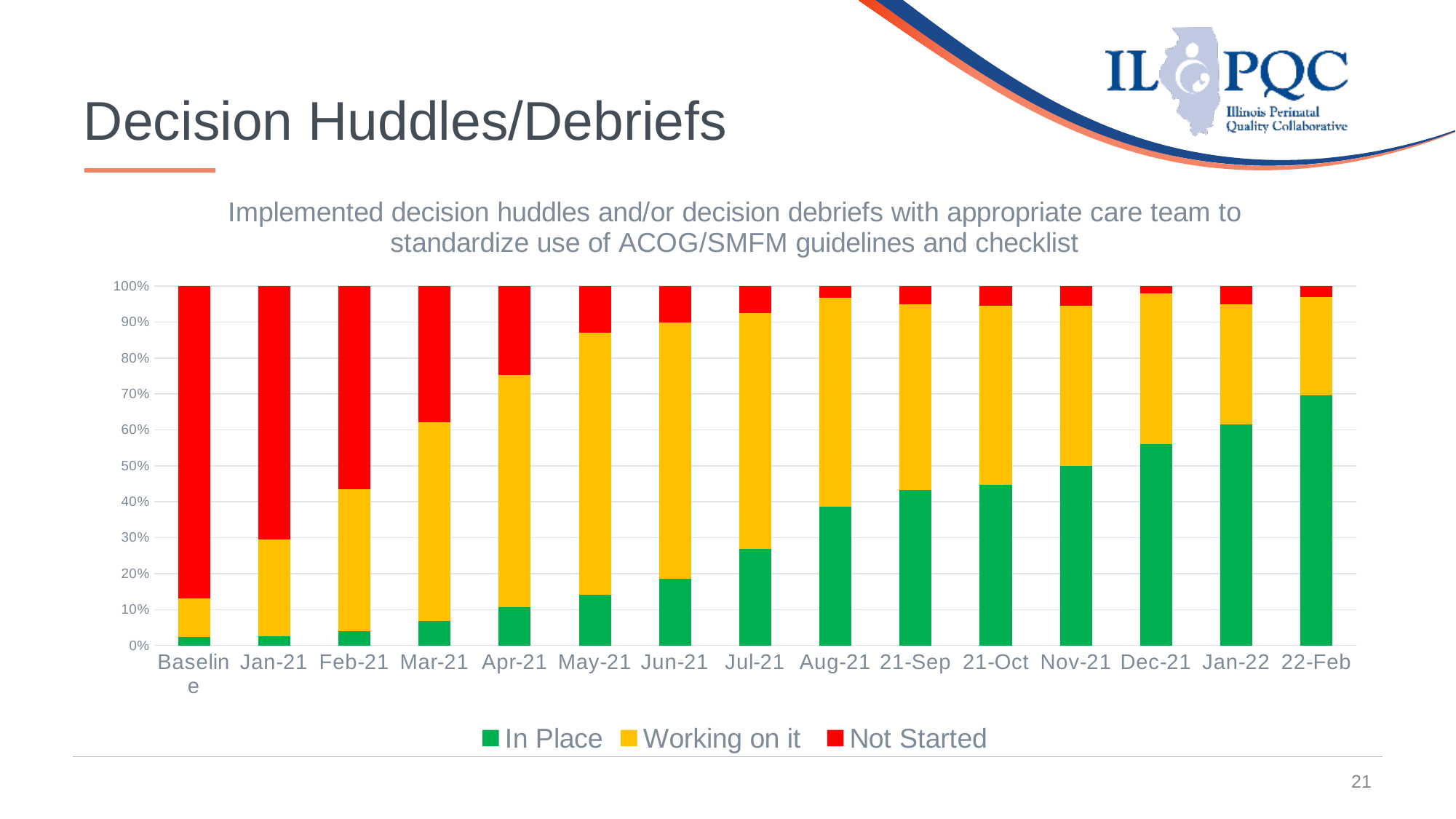
How many series does the legend list? 3 How many time-period categories are shown along the x axis? 15 Which series is shown in red in the legend? Not Started What kind of chart is shown on the slide? Stacked bar chart In which period is the In Place share the highest? 22-Feb Is the Not Started share for Baseline greater or less than 80%? greater Does the In Place share rise or fall from Baseline to 22-Feb? Rises Is the In Place share for Jul-21 greater or less than 30%? less Which series is shown in green in the legend? In Place Does the Not Started share rise or fall from Baseline to 22-Feb? Falls In which period is the Not Started share the highest? Baseline Is the In Place share for 22-Feb greater or less than 60%? greater